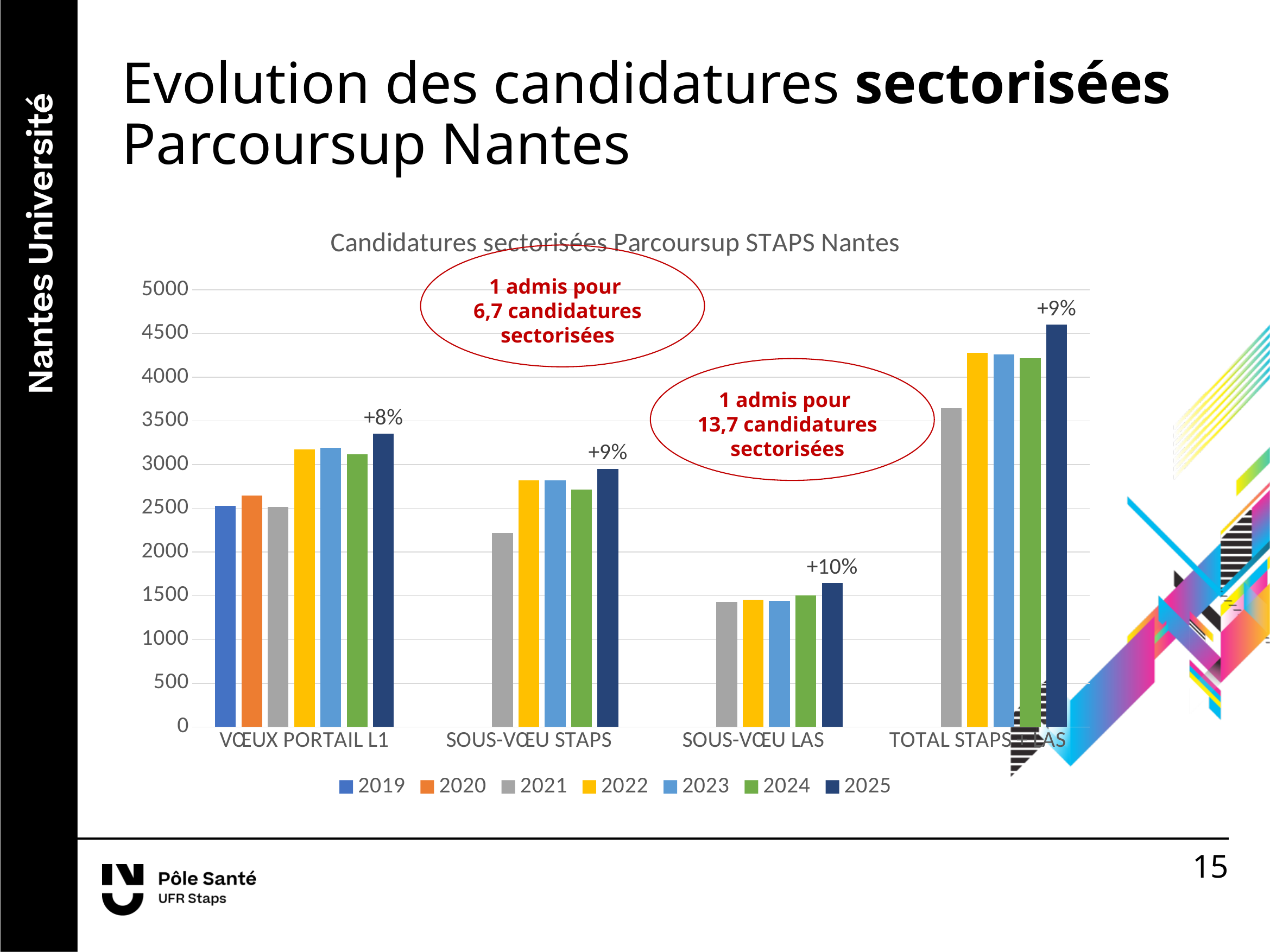
Is the 2025 value for TOTAL STAPS + LAS greater or less than 4000? greater Which category has the highest 2025 bar? TOTAL STAPS + LAS What percentage change is printed above the SOUS-VŒU LAS group? +10% How many series does the legend list? 7 Is the 2021 value for SOUS-VŒU STAPS greater or less than 2500? less Is the 2025 value for SOUS-VŒU LAS greater or less than 2000? less For VŒUX PORTAIL L1, which is larger, the 2020 bar or the 2021 bar? 2020 Which category has the lowest 2025 bar? SOUS-VŒU LAS What kind of chart is shown on the slide? bar chart What is the title of the chart? Candidatures sectorisées Parcoursup STAPS Nantes How many categories are shown on the x axis? 4